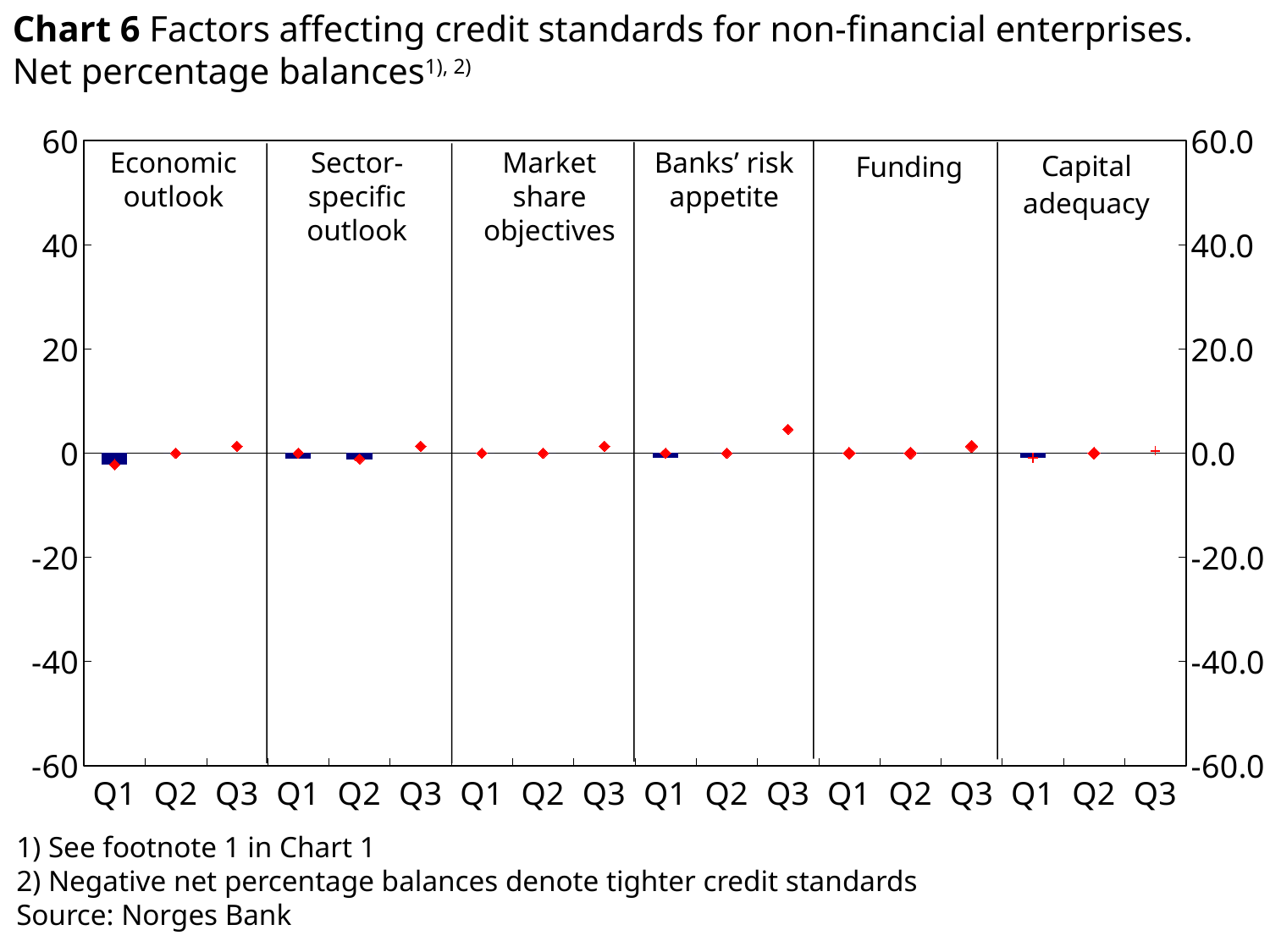
Is the red marker for Q3 under Banks' risk appetite greater or less than 0? greater Which factor panel has the highest red marker value in Q3? Banks' risk appetite What is the highest value shown on the left vertical axis? 60 Do the red markers under Economic outlook rise or fall from Q1 to Q3? rise What is the lowest value shown on the right vertical axis? -60.0 How many factor panels are shown on the chart? 6 Is the red marker for Q3 under Banks' risk appetite greater or less than 20? less Is the red marker for Q3 under Banks' risk appetite higher or lower than the red marker for Q3 under Funding? higher Is the blue bar for Q1 under Economic outlook greater or less than -20? greater How many quarters are shown on the x axis within each factor panel? 3 Which factor panel is listed first on the chart? Economic outlook